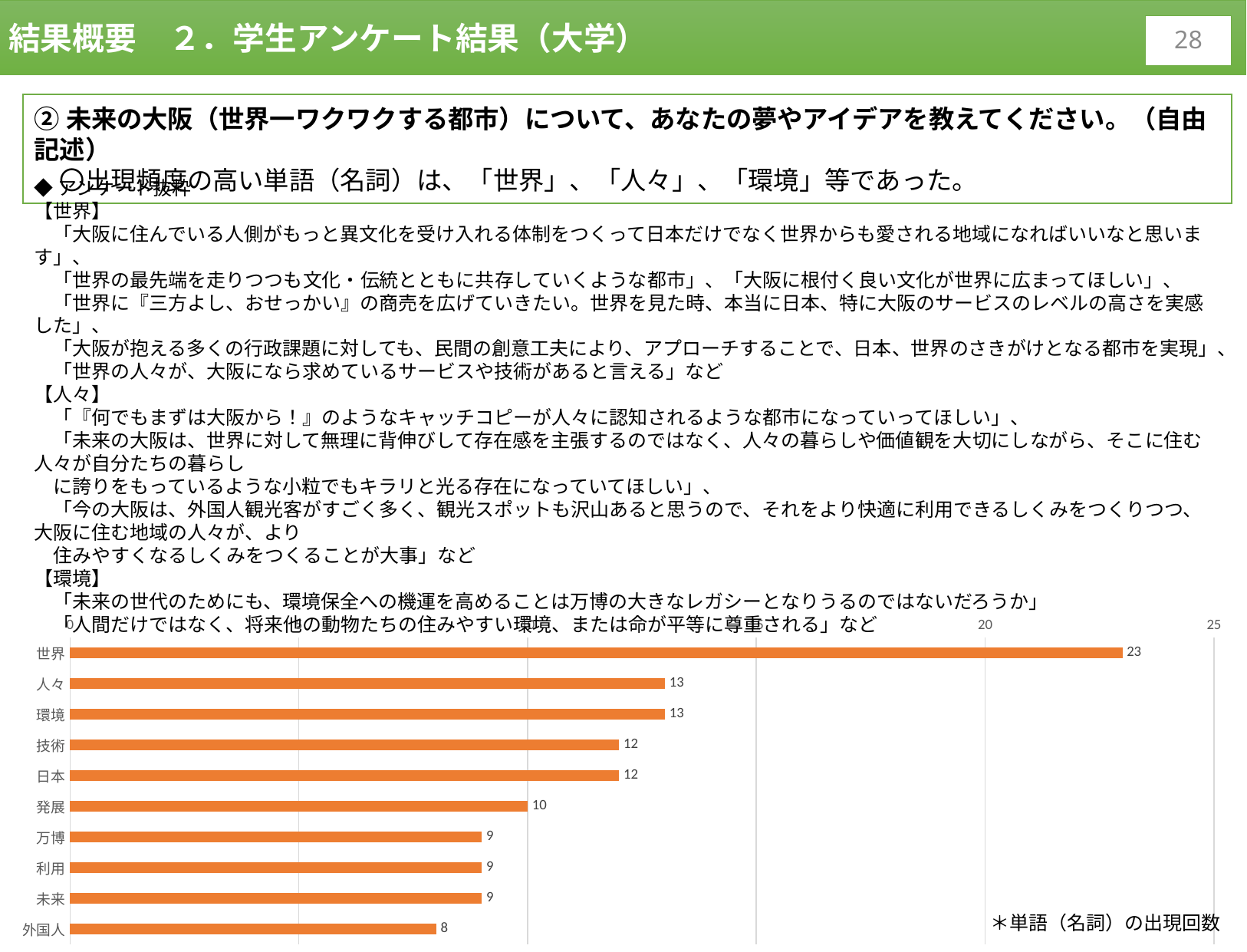
What is the value for 発展 in the bar chart? 10 What is the value for 外国人 in the bar chart? 8 How many categories are shown in the bar chart? 10 What colour are the bars in the chart? orange Which category has the lowest value in the bar chart? 外国人 Which is larger, the value for 発展 or the value for 万博? 発展 What is the value for 世界 in the bar chart? 23 What kind of chart is shown on the slide? bar chart Is the value for 世界 greater or less than 20? greater Which category has the highest value in the bar chart? 世界 What is the difference between the values for 世界 and 人々? 10 What is the value for 技術 in the bar chart? 12